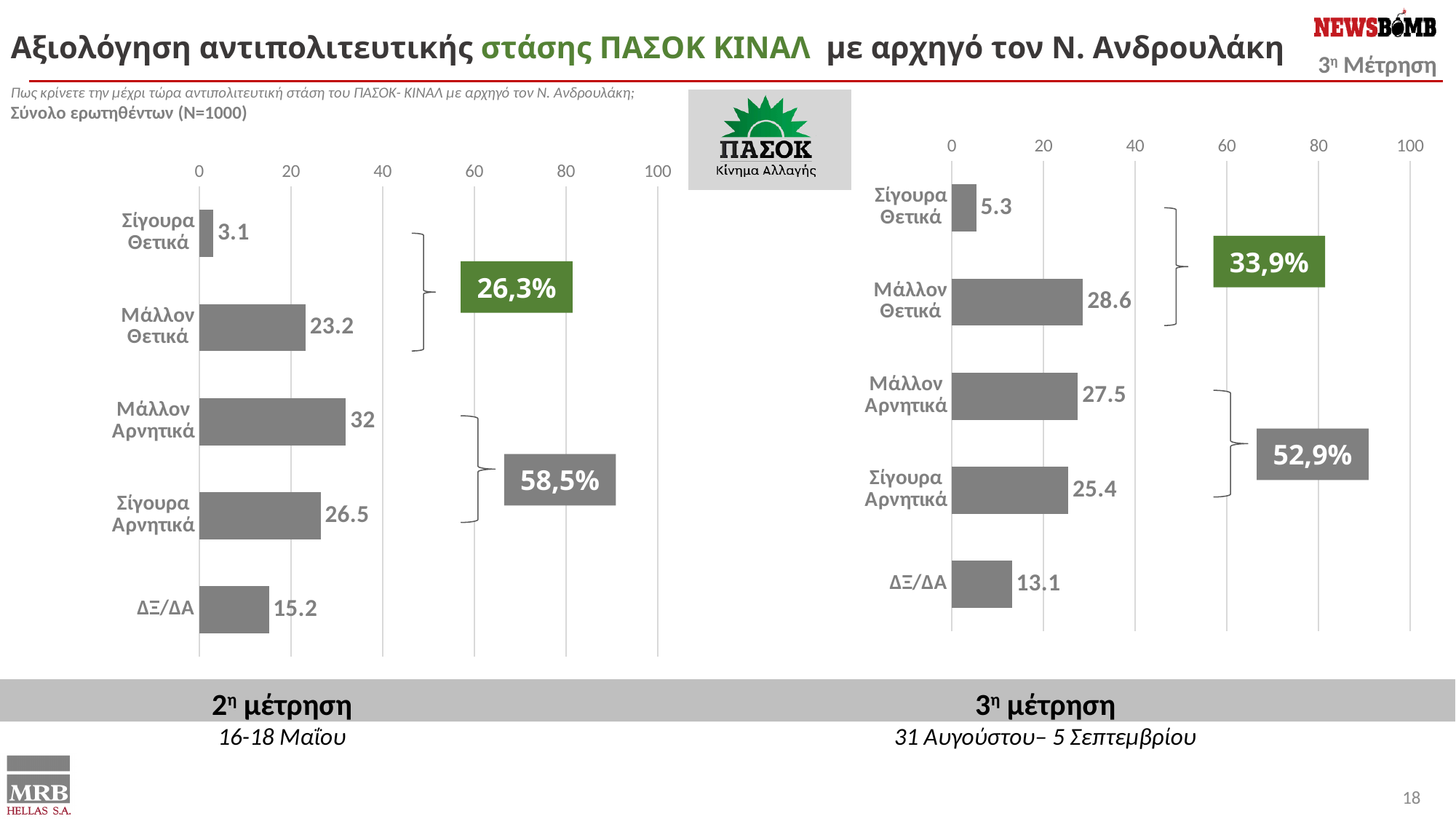
In the left chart (2η μέτρηση), what is the difference between Μάλλον Αρνητικά and Σίγουρα Αρνητικά? 5.5 In the right chart (3η μέτρηση), what combined percentage is shown in the green box for the positive responses? 33,9% In the right chart (3η μέτρηση), is the value for Μάλλον Αρνητικά greater or less than 20? greater What kind of chart is the right chart (3η μέτρηση)? bar chart In the right chart (3η μέτρηση), what is the value for Μάλλον Θετικά? 28.6 In the left chart (2η μέτρηση), what is the value for ΔΞ/ΔΑ? 15.2 In the left chart (2η μέτρηση), which category has the highest value? Μάλλον Αρνητικά In the left chart (2η μέτρηση), what combined percentage is shown in the grey box for the negative responses? 58,5% In the right chart (3η μέτρηση), which is larger: Σίγουρα Αρνητικά or ΔΞ/ΔΑ? Σίγουρα Αρνητικά How many categories does the left chart (2η μέτρηση) show? 5 In the left chart (2η μέτρηση), what is the value for Μάλλον Αρνητικά? 32 In the right chart (3η μέτρηση), which category has the lowest value? Σίγουρα Θετικά